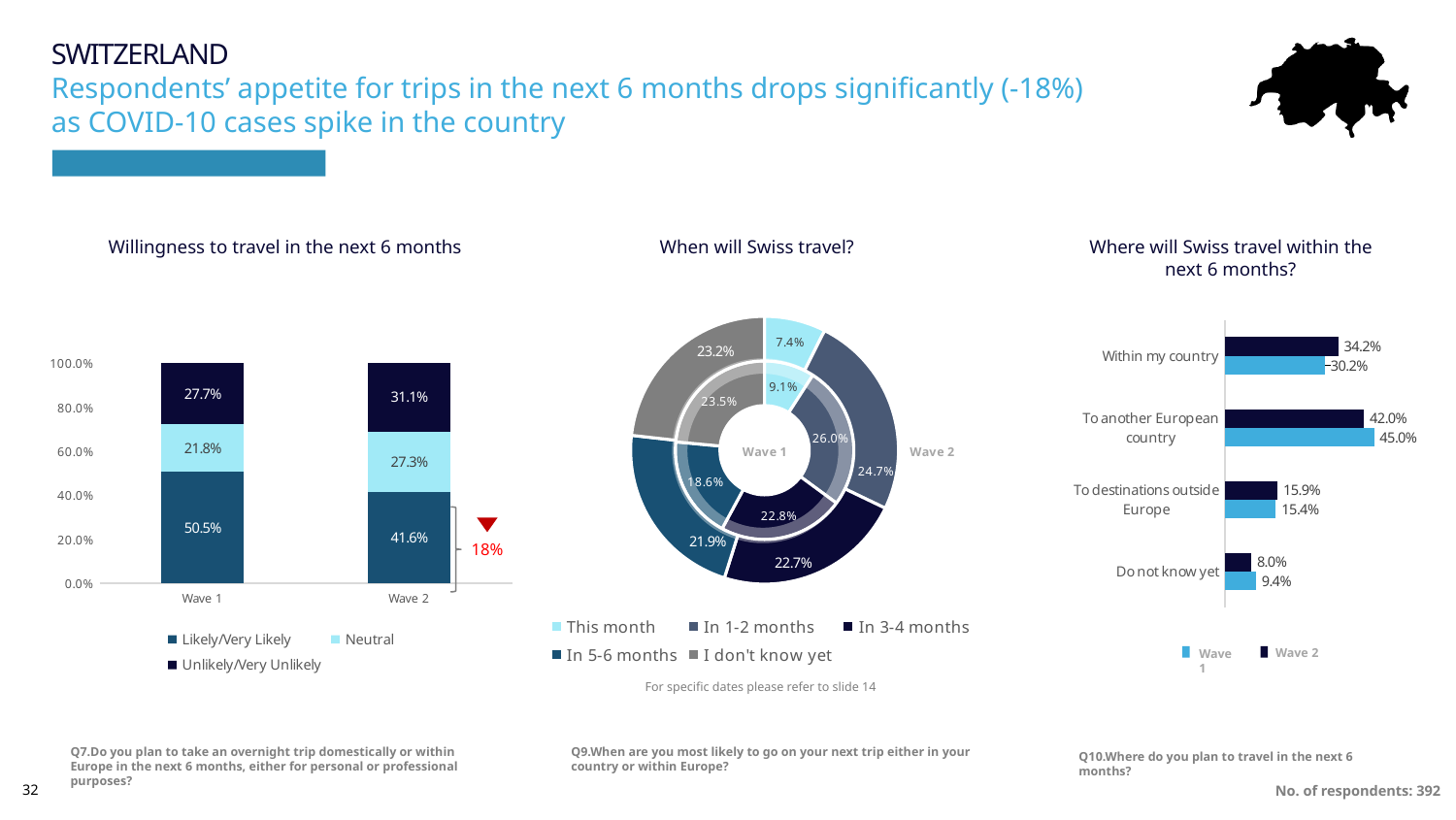
In the 'Where will Swiss travel within the next 6 months?' chart, what is the Wave 1 value for 'To another European country'? 45.0% In the 'Willingness to travel in the next 6 months' chart, what is the Likely/Very Likely value for Wave 2? 41.6% In the 'When will Swiss travel?' chart, how many categories does the legend list? 5 In the 'Where will Swiss travel within the next 6 months?' chart, is the Wave 2 value for 'Within my country' larger or smaller than the Wave 1 value? Larger In the 'Where will Swiss travel within the next 6 months?' chart, which category has the highest Wave 2 value? To another European country In the 'When will Swiss travel?' chart, which category has the smallest Wave 2 share? This month What kind of chart is 'When will Swiss travel?'? Doughnut chart In the 'Willingness to travel in the next 6 months' chart, what is the Neutral value for Wave 1? 21.8% In the 'When will Swiss travel?' chart, what is the Wave 2 share for 'In 1-2 months'? 24.7% In the 'Where will Swiss travel within the next 6 months?' chart, what is the difference between the Wave 1 and Wave 2 values for 'Do not know yet'? 1.4% In the 'Willingness to travel in the next 6 months' chart, how many series does the legend list? 3 In the 'Willingness to travel in the next 6 months' chart, what is the difference between the Likely/Very Likely values for Wave 1 and Wave 2? 8.9%